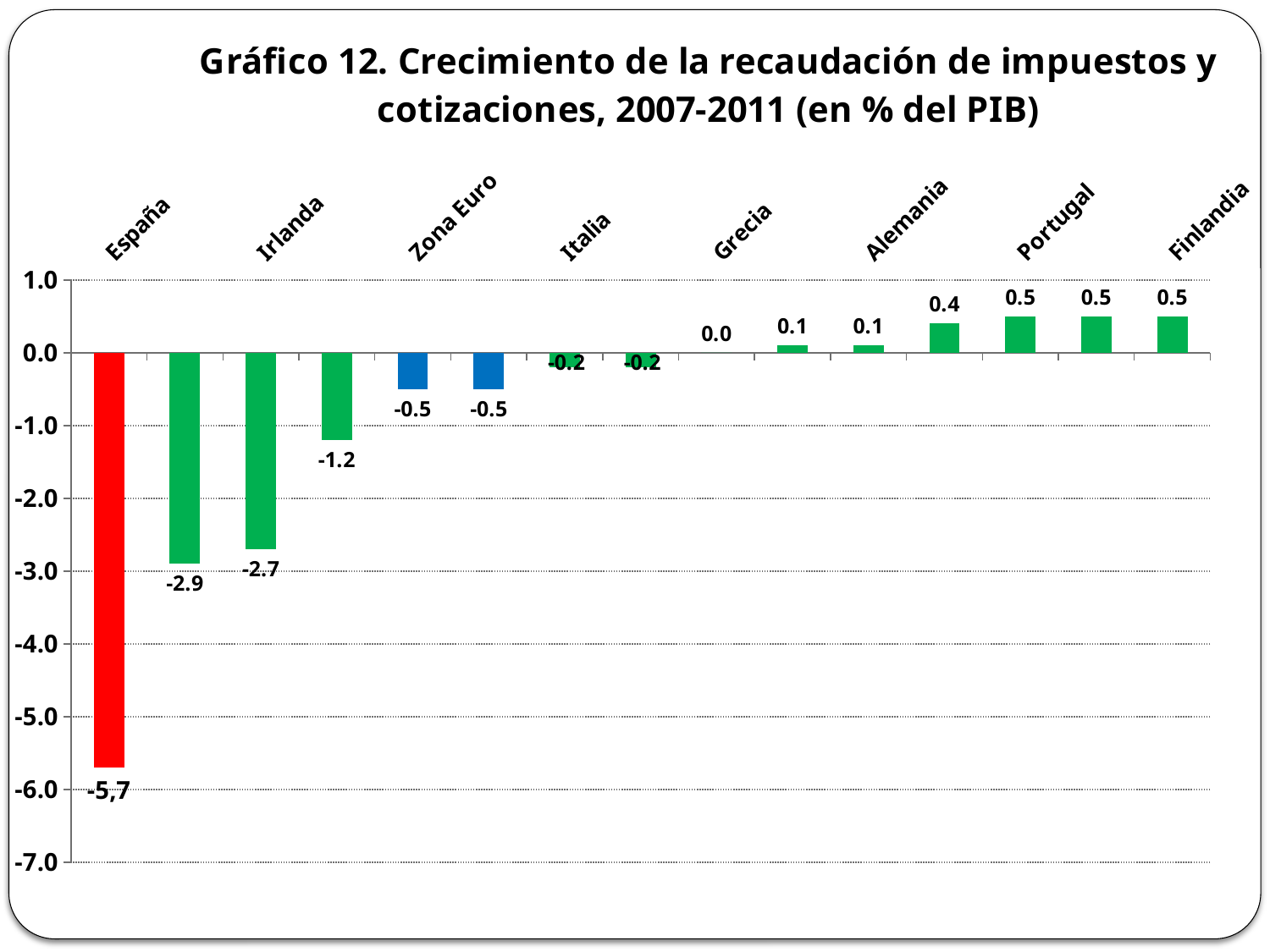
What is the value shown for España? -5,7 What is the value shown for Irlanda? -2.7 Is the value for España greater or less than -5.0? less What period does the chart title say the data covers? 2007-2011 What colour is the bar for España? red What is the value shown for Portugal? 0.5 Which category has the lowest value? España What is the value shown for Grecia? 0.0 Which is larger, the value for España or the value for Irlanda? Irlanda What kind of chart is shown on the slide? bar chart Do the values generally rise or fall from left to right along the x axis? rise What is the value shown for Zona Euro? -0.5